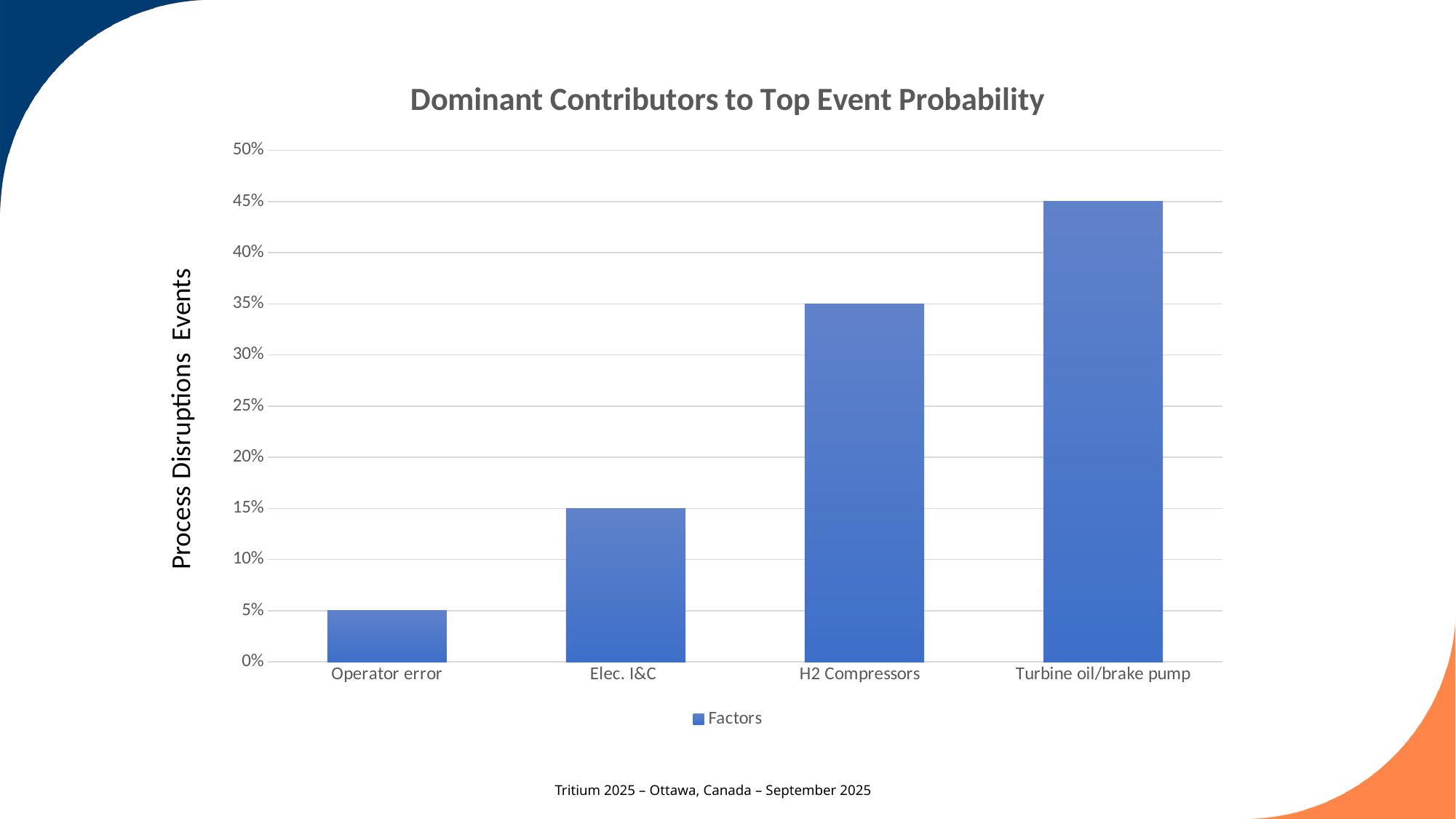
How many categories are shown on the x axis? 4 What is the value for Operator error? 5% What is the value for Turbine oil/brake pump? 45% Which is larger, the value for Elec. I&C or the value for H2 Compressors? H2 Compressors What kind of chart is shown on the slide? bar chart What is the value for Elec. I&C? 15% Which category has the lowest value? Operator error Which category has the highest value? Turbine oil/brake pump What is the title of the chart? Dominant Contributors to Top Event Probability What is the value for H2 Compressors? 35% Is the value for H2 Compressors greater or less than 30%? greater What is the difference between the values for Turbine oil/brake pump and H2 Compressors? 10%